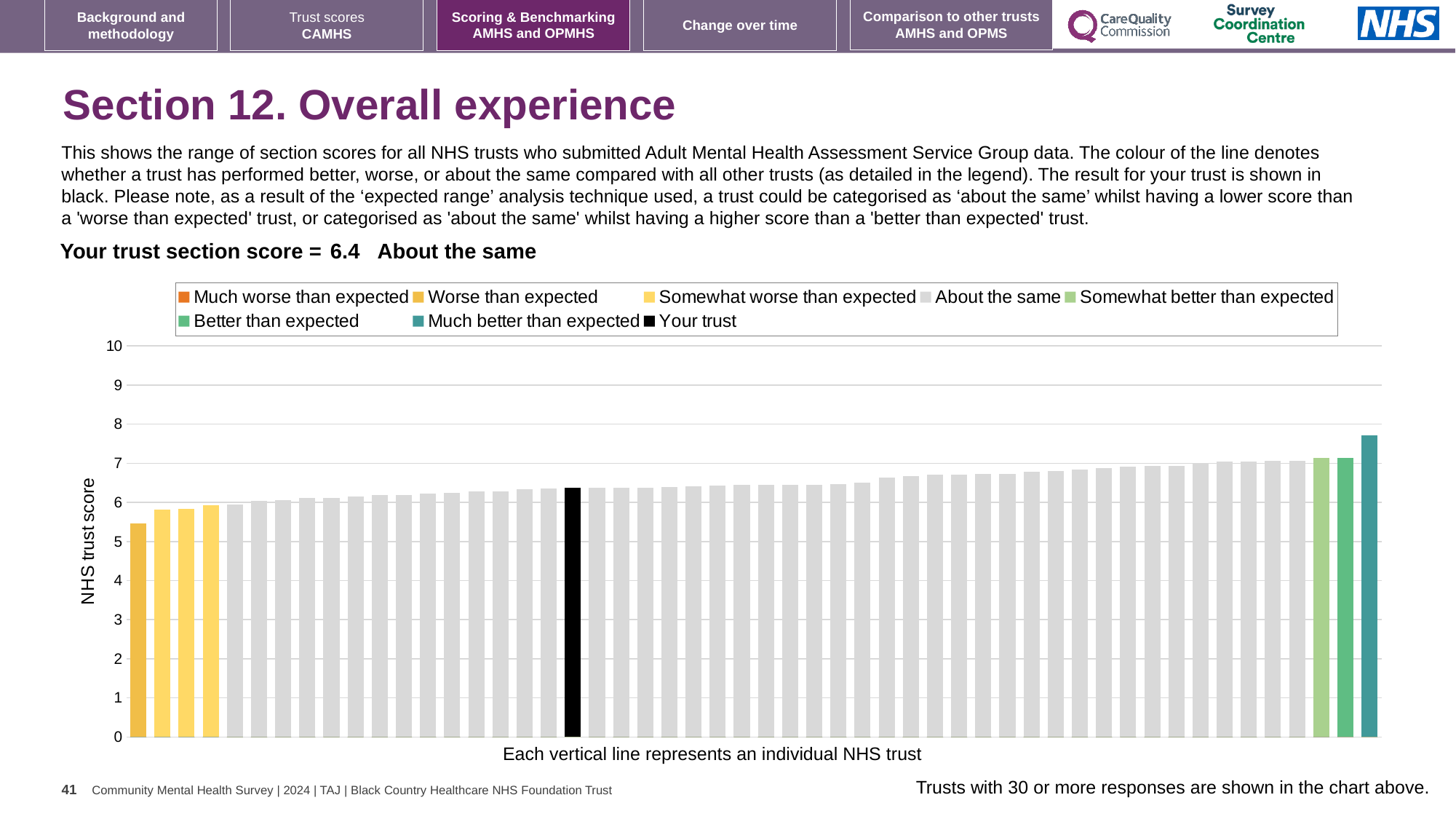
Is the value for the leftmost bar in the chart greater or less than 6? less Is the value for the tallest bar in the chart greater or less than 7? greater How many entries does the chart legend list? 8 Is the value for your trust's bar greater or less than 6? greater What is the title of the vertical axis? NHS trust score Which legend category does the tallest bar in the chart belong to? Much better than expected Which is larger, the value for your trust's bar or the value for the leftmost bar? your trust's bar What is the section score for your trust shown on the slide? 6.4 Which category is your trust placed in according to the slide? About the same What kind of chart is shown on the slide? bar chart What colour is used for the bar representing your trust? black Do the bar values rise or fall from left to right across the chart? rise